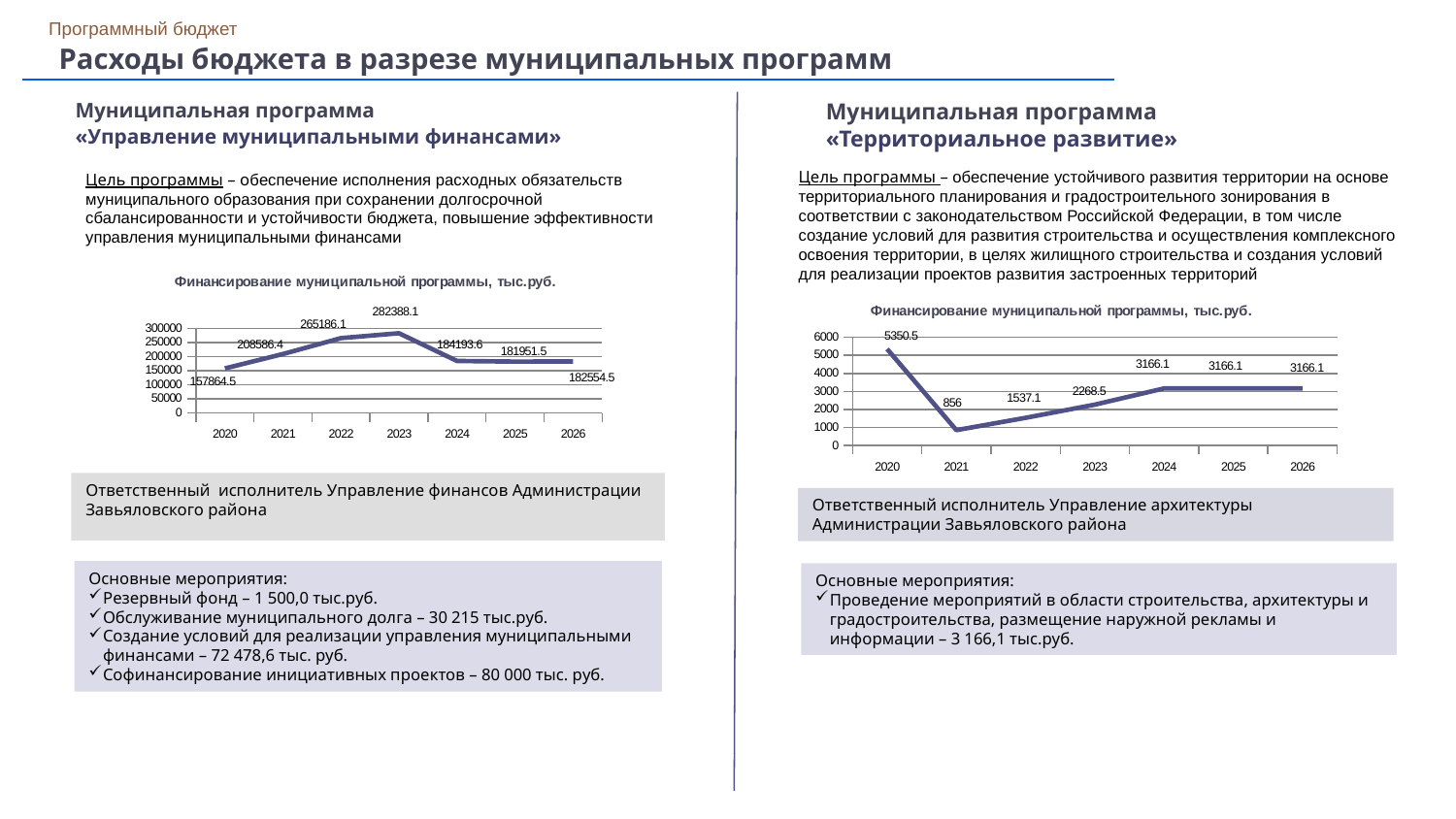
On the right chart, which is larger, the value for 2022 or the value for 2023? 2023 On the left chart, which year has the highest value? 2023 What type of chart is the right chart? line chart On the left chart, what is the value for 2023? 282388.1 On the left chart, what is the difference between the values for 2023 and 2024? 98194.5 On the left chart, which year has the lowest value? 2020 On the right chart, what is the value for 2021? 856 On the right chart, do the values rise or fall from 2021 to 2024? rise On the left chart, what is the value for 2020? 157864.5 On the left chart, how many years are plotted? 7 On the right chart, what is the value for 2020? 5350.5 On the right chart, which year has the lowest value? 2021